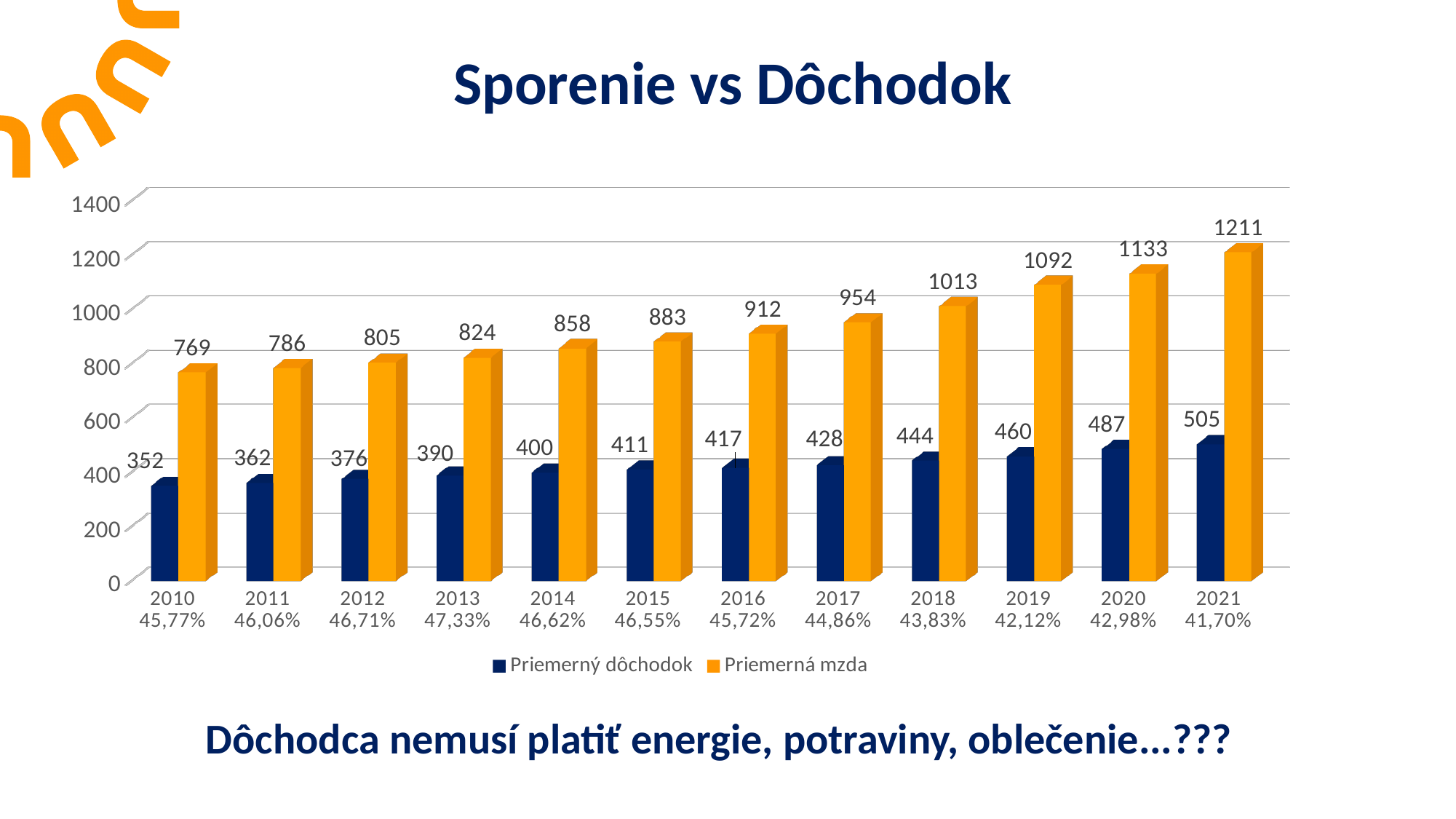
What is the value of Priemerný dôchodok for 2015? 411 Which year has the highest Priemerný dôchodok? 2021 Does Priemerná mzda rise or fall from 2010 to 2021? Rise Which year has the lowest Priemerná mzda? 2010 How many years are shown on the x axis? 12 What is the title of the chart? Sporenie vs Dôchodok What kind of chart is shown on the slide? Bar chart How many series does the legend list? 2 Which is larger: Priemerná mzda in 2010 or Priemerný dôchodok in 2021? Priemerná mzda in 2010 What is the difference between Priemerná mzda and Priemerný dôchodok in 2018? 569 What is the value of Priemerná mzda for 2013? 824 What is the value of Priemerná mzda for 2021? 1211